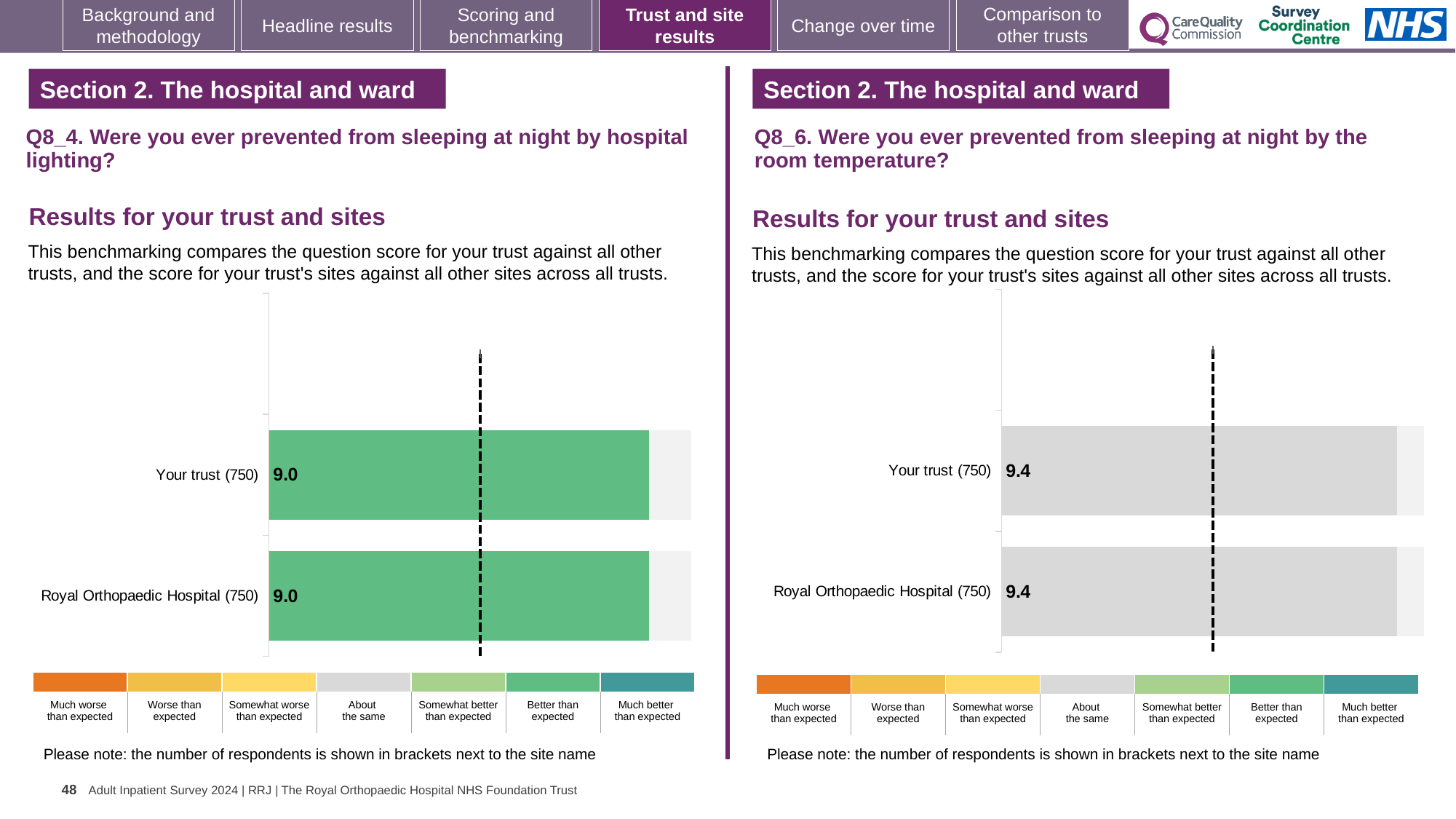
How many respondents are shown in brackets for Royal Orthopaedic Hospital on the Q8_6 room temperature chart? 750 On the Q8_4 hospital lighting chart, what is the score for Your trust (750)? 9.0 How many bars are plotted on the Q8_4 hospital lighting chart? 2 On the Q8_4 hospital lighting chart, what is the score for Royal Orthopaedic Hospital (750)? 9.0 On the Q8_6 room temperature chart, what is the difference between the score for Your trust and the score for Royal Orthopaedic Hospital? 0.0 On the Q8_4 hospital lighting chart, what is the difference between the score for Your trust and the score for Royal Orthopaedic Hospital? 0.0 On the Q8_6 room temperature chart, what is the score for Your trust (750)? 9.4 On the Q8_6 room temperature chart, what is the score for Royal Orthopaedic Hospital (750)? 9.4 Which benchmarking category does the colour of the bars on the Q8_6 room temperature chart correspond to in the legend? About the same How many bars are plotted on the Q8_6 room temperature chart? 2 Which benchmarking category does the colour of the bars on the Q8_4 hospital lighting chart correspond to in the legend? Better than expected What kind of chart is used for the Q8_4 hospital lighting results? Bar chart